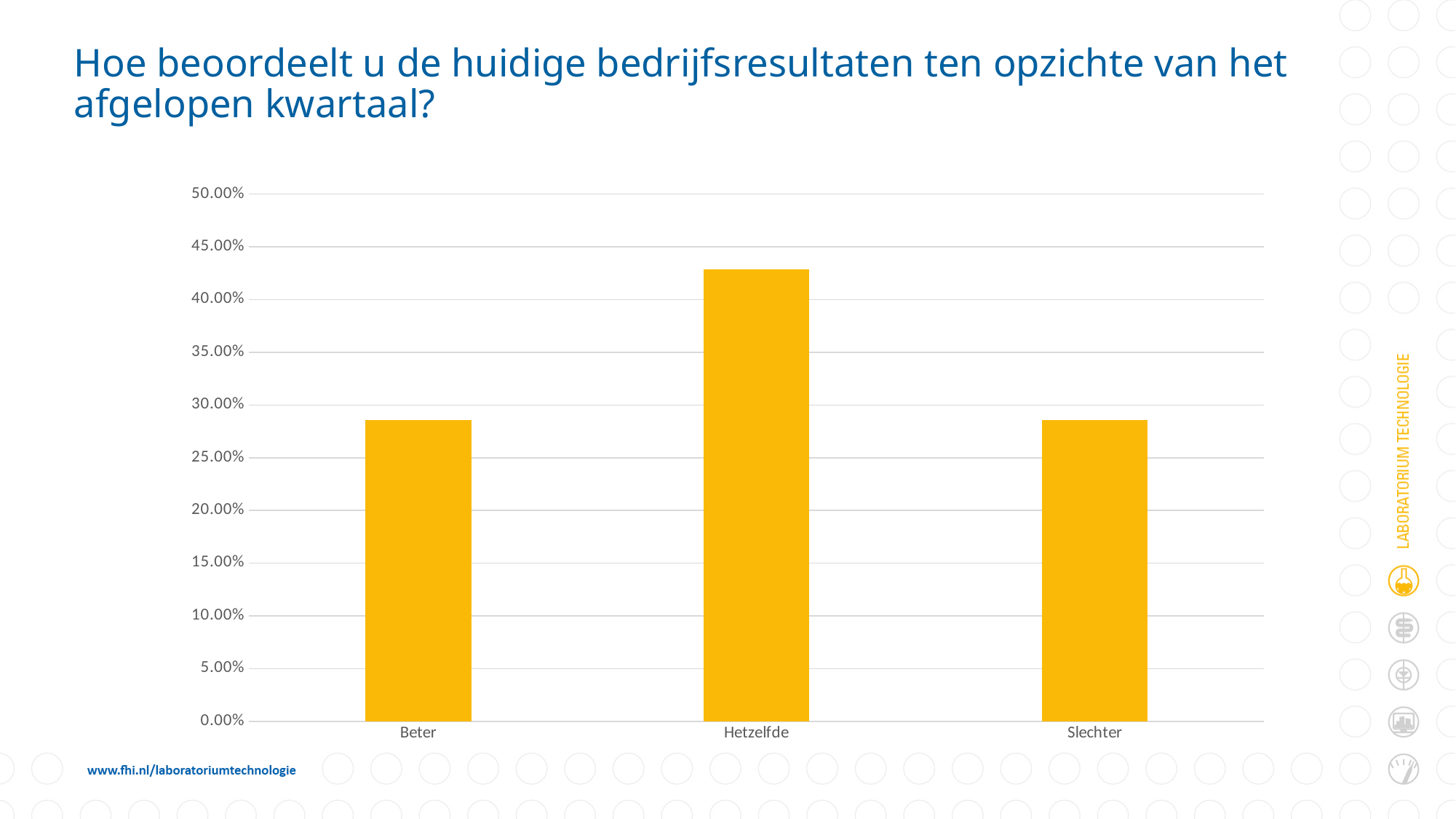
Is the value for Beter greater or less than 30.00%? less Is the value for Hetzelfde greater or less than 40.00%? greater What is the title of the chart on the slide? Hoe beoordeelt u de huidige bedrijfsresultaten ten opzichte van het afgelopen kwartaal? Which category has the highest value in the chart? Hetzelfde Which is larger, the value for Hetzelfde or the value for Beter? Hetzelfde Is the value for Slechter greater or less than 25.00%? greater What kind of chart is shown on the slide? bar chart What colour are the bars in the chart? yellow How many categories are shown on the x axis of the chart? 3